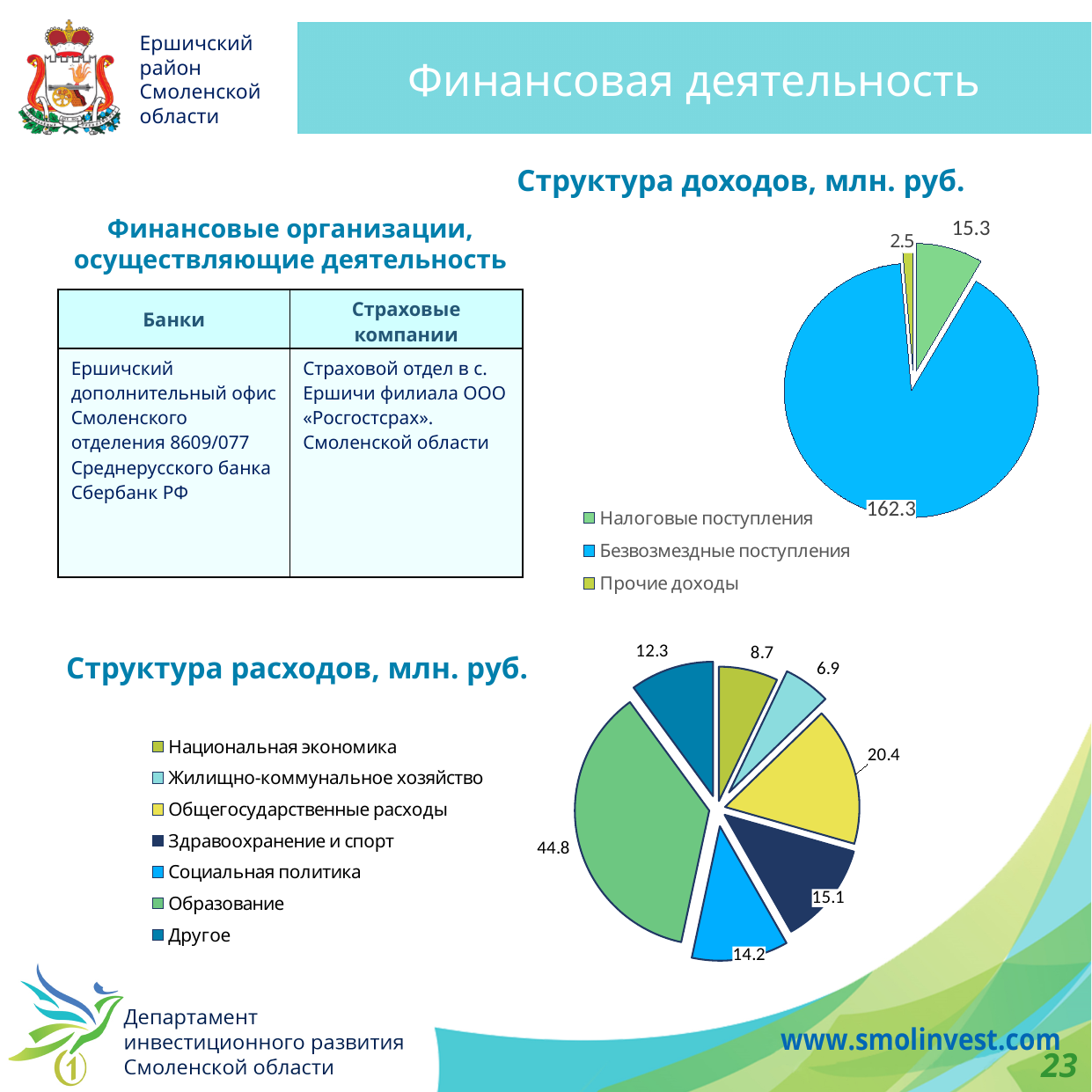
How many slices does the 'Структура расходов, млн. руб.' pie chart have? 7 In the 'Структура расходов, млн. руб.' pie chart, what is the value for Здравоохранение и спорт? 15.1 What type of chart is used for 'Структура расходов, млн. руб.'? Pie chart In the 'Структура расходов, млн. руб.' pie chart, what is the value for Образование? 44.8 In the 'Структура доходов, млн. руб.' pie chart, which category has the largest value? Безвозмездные поступления In the 'Структура доходов, млн. руб.' pie chart, what is the value for Прочие доходы? 2.5 In the 'Структура расходов, млн. руб.' pie chart, what is the difference between Образование and Общегосударственные расходы? 24.4 In the 'Структура доходов, млн. руб.' pie chart, what is the difference between Безвозмездные поступления and Налоговые поступления? 147.0 In the 'Структура расходов, млн. руб.' pie chart, which category has the smallest value? Жилищно-коммунальное хозяйство In the 'Структура расходов, млн. руб.' pie chart, which is larger: Общегосударственные расходы or Социальная политика? Общегосударственные расходы In the 'Структура доходов, млн. руб.' pie chart, what is the value for Безвозмездные поступления? 162.3 How many categories does the legend of the 'Структура доходов, млн. руб.' chart list? 3